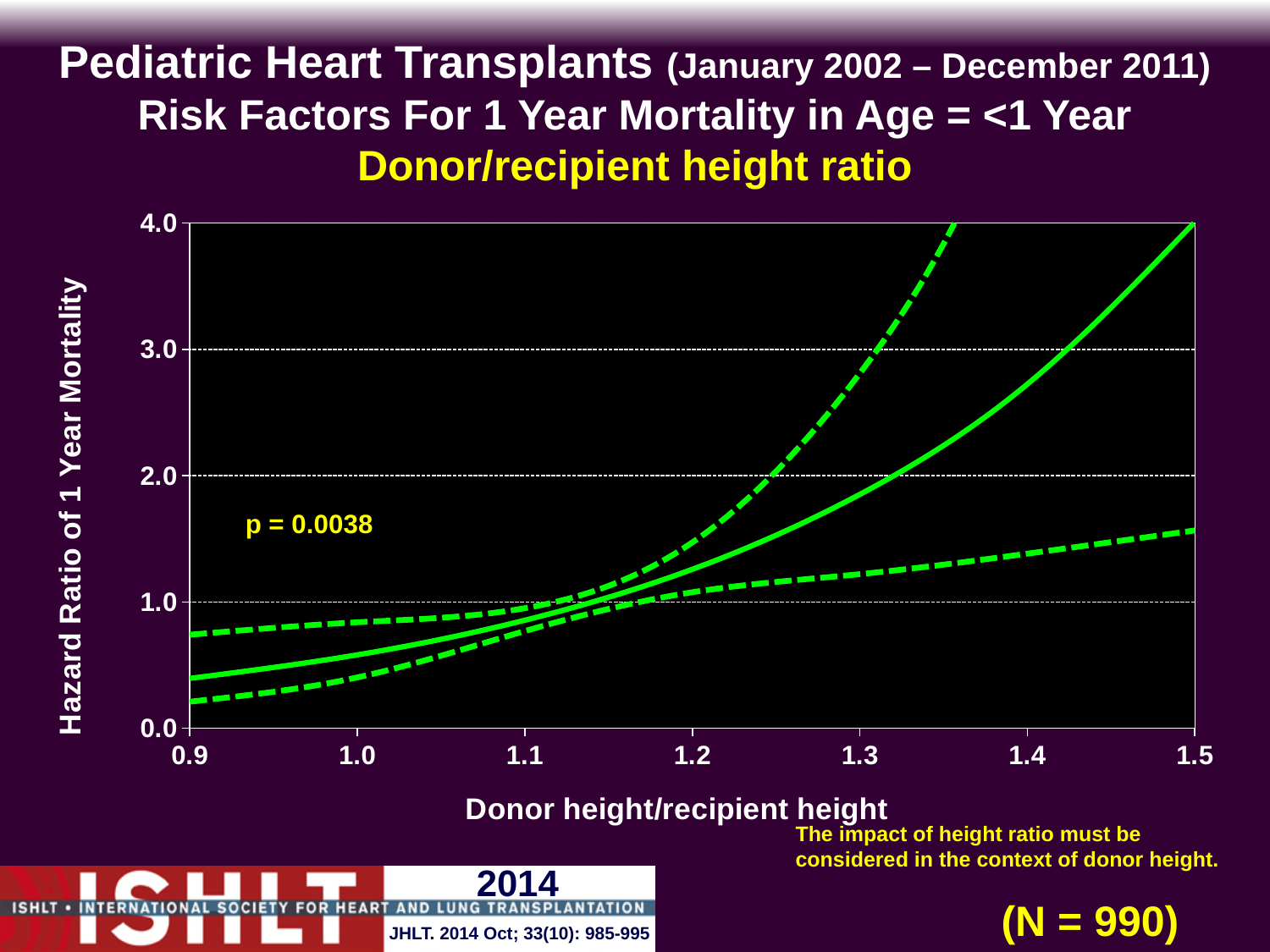
Is the hazard ratio on the solid line at a height ratio of 1.0 greater or less than 1.0? less What is the label of the y axis? Hazard Ratio of 1 Year Mortality Is the hazard ratio on the solid line at a height ratio of 1.4 greater or less than 2.0? greater At a height ratio of 1.5, which is larger: the solid line or the lower dashed line? the solid line How many lines are plotted on the chart? 3 What p-value is printed on the chart? p = 0.0038 Is the hazard ratio on the solid line at a height ratio of 1.3 greater or less than 2.0? less What kind of chart is shown on the slide? line chart Does the solid hazard ratio line rise or fall as the donor height/recipient height ratio increases from 0.9 to 1.5? rises